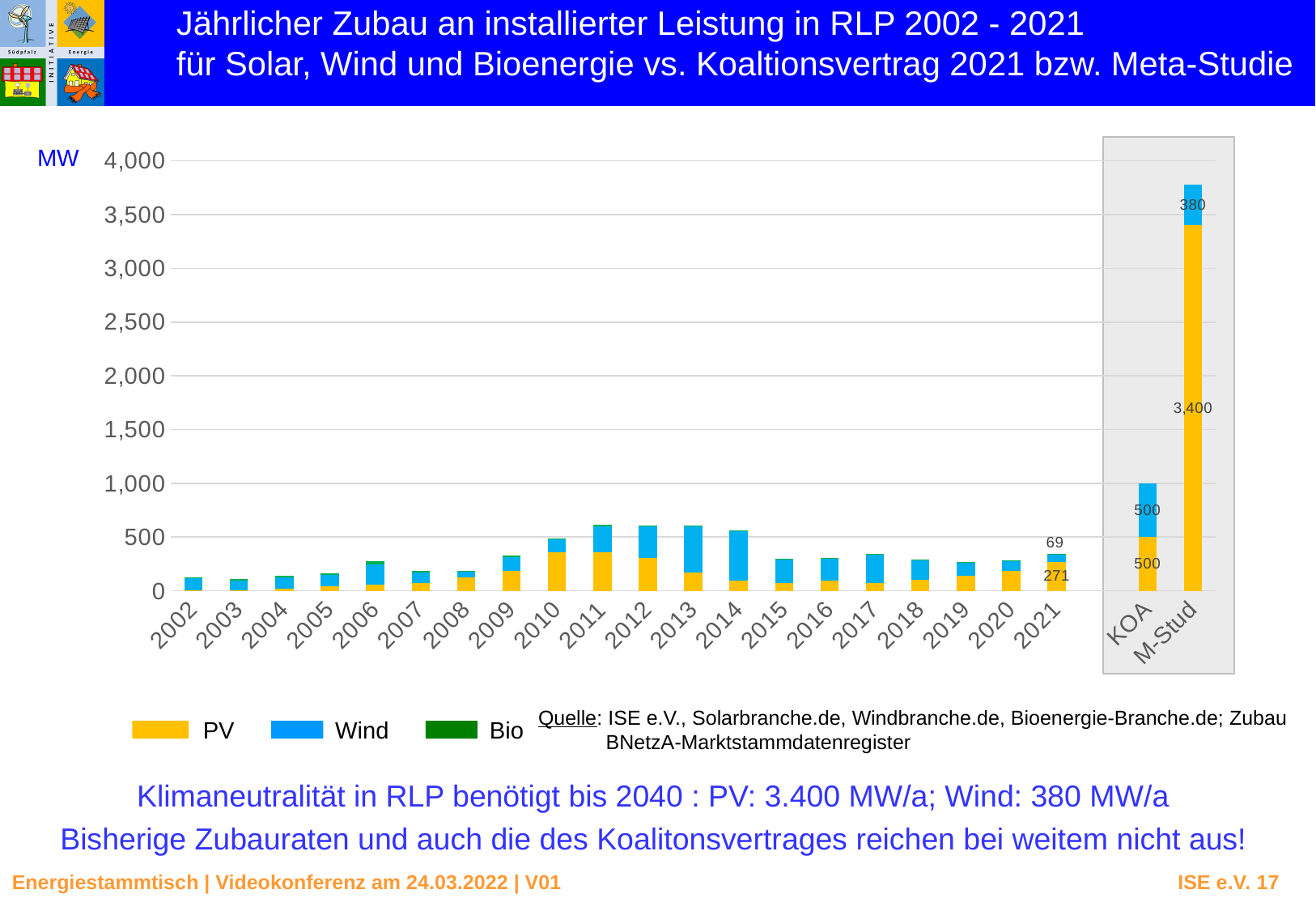
Which is larger for 2021, the PV value or the Wind value? PV What is the Wind value for M-Stud? 380 What is the PV value for KOA? 500 What unit is shown on the y axis? MW What is the PV value for M-Stud? 3,400 What is the Wind value for 2021? 69 What is the PV value for 2021? 271 Is the total bar value for 2002 greater or less than 500? less Which category has the tallest bar overall? M-Stud Is the total bar value for 2011 greater or less than 500? greater How many series does the legend list? 3 What is the difference between the PV value for M-Stud and the PV value for KOA? 2,900